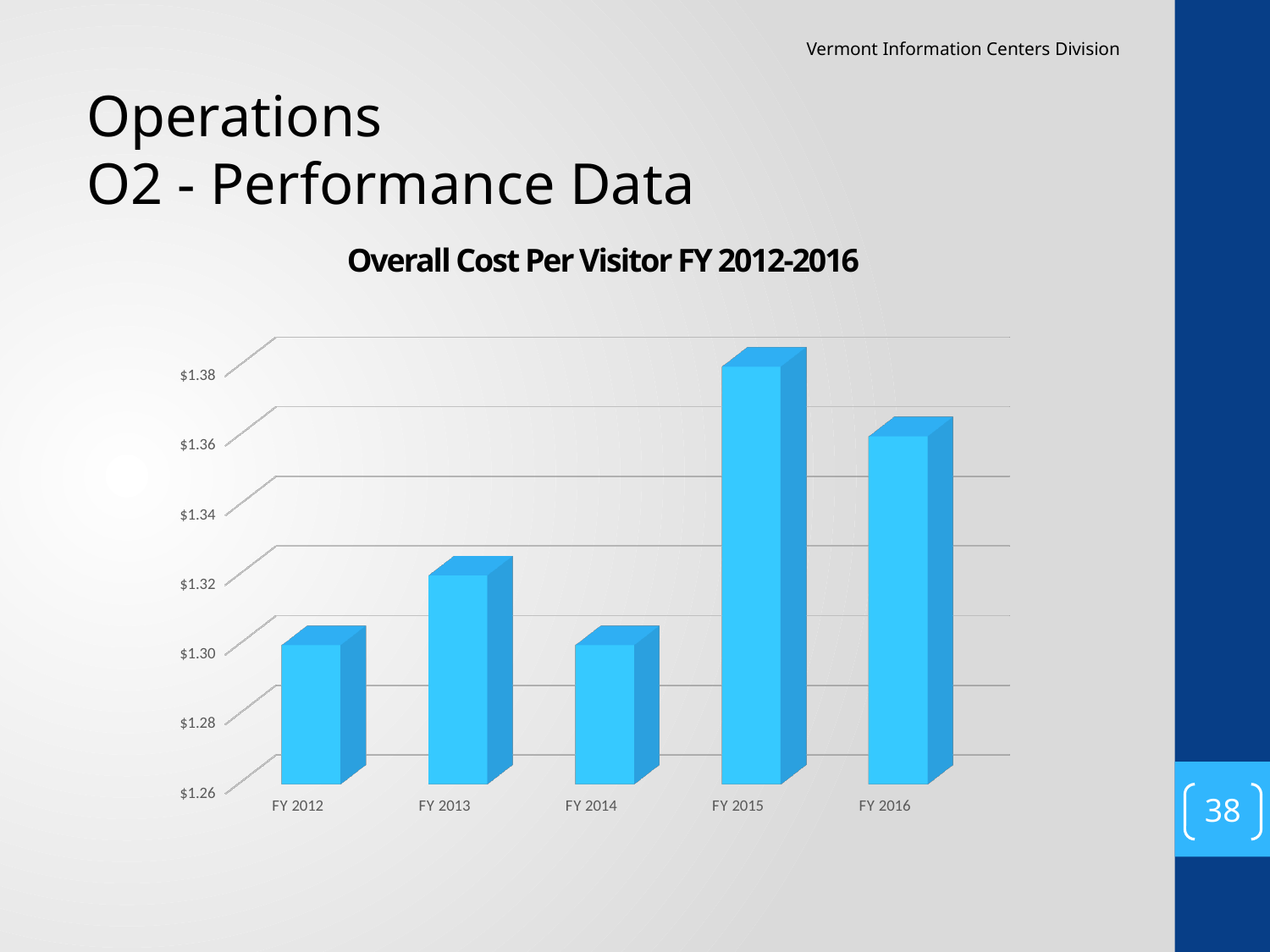
Is the value for FY 2015 greater or less than $1.36? greater Does the cost per visitor rise or fall from FY 2014 to FY 2015? rise Which fiscal year has the highest overall cost per visitor? FY 2015 Which is larger, the value for FY 2015 or the value for FY 2016? FY 2015 How many fiscal years are plotted in the chart? 5 What is the title of the chart? Overall Cost Per Visitor FY 2012-2016 Is the value for FY 2013 greater or less than $1.34? less Which is larger, the value for FY 2013 or the value for FY 2014? FY 2013 Is the value for FY 2012 greater or less than $1.32? less What kind of chart is shown on the slide? bar chart